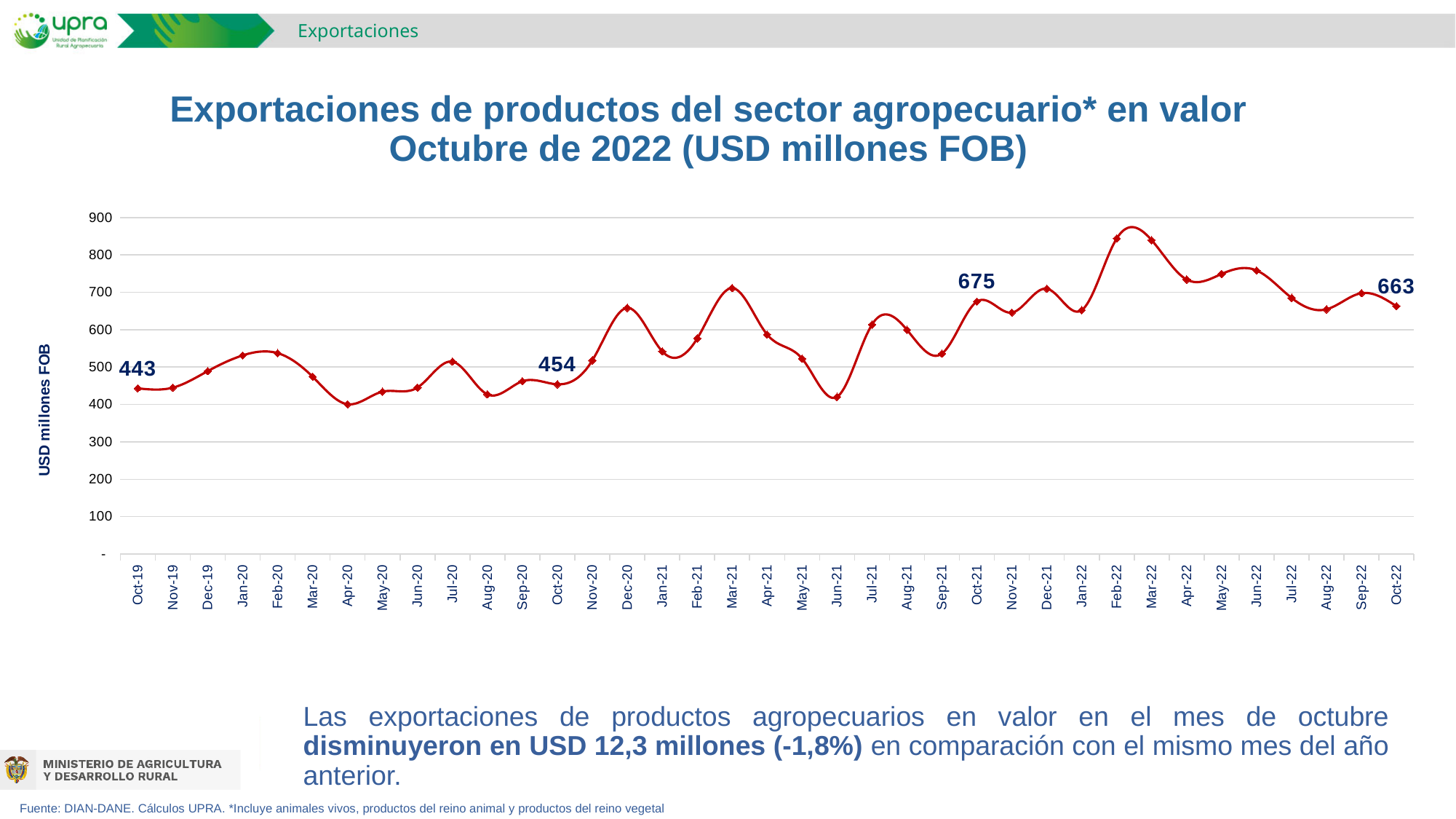
Which is larger, the value for Oct-21 or the value for Oct-22? Oct-21 Is the value for Feb-22 greater or less than 800? greater What is the value for Oct-22? 663 Which month has the highest value on the chart? Feb-22 How many monthly data points are plotted on the chart? 37 What is the value for Oct-21? 675 What is the difference between the values for Oct-21 and Oct-22? 12 Is the value for Apr-20 greater or less than 500? less What is the value for Oct-19? 443 What kind of chart is shown on the slide? line chart What is the value for Oct-20? 454 What is the difference between the values for Oct-20 and Oct-19? 11